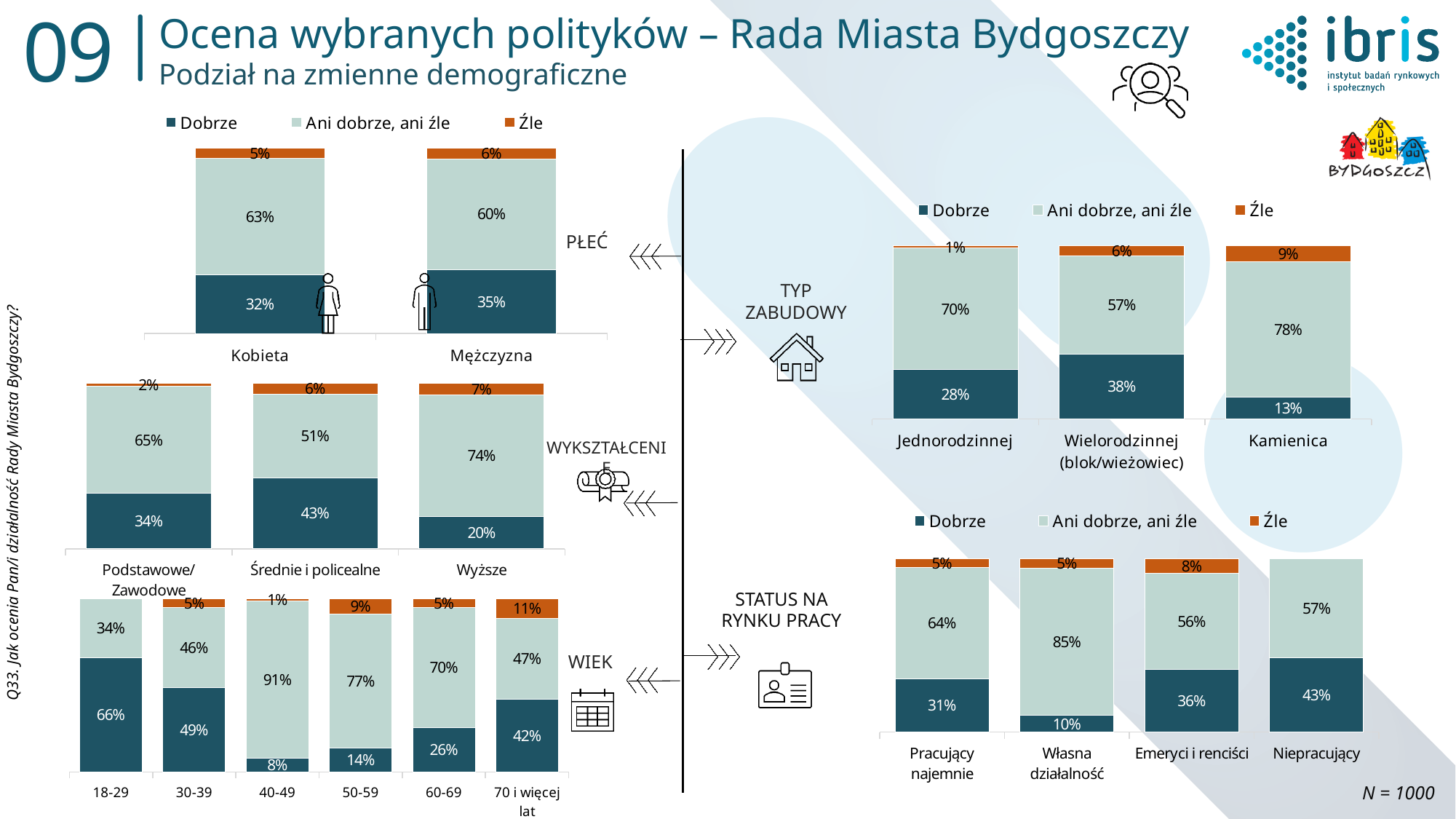
In the PŁEĆ chart, what percentage of women (Kobieta) rated the council 'Dobrze'? 32% In the WIEK chart, what is the difference between the 'Dobrze' values for 18-29 and 30-39? 17% In the STATUS NA RYNKU PRACY chart, how many series does the legend list? 3 In the WYKSZTAŁCENIE chart, what is the 'Ani dobrze, ani źle' value for Wyższe? 74% In the WIEK chart, which age group has the highest 'Dobrze' share? 18-29 In the STATUS NA RYNKU PRACY chart, what is the 'Dobrze' value for Własna działalność? 10% In the WIEK chart, what is the 'Ani dobrze, ani źle' value for the 40-49 group? 91% In the WIEK chart, how many age groups are shown? 6 In the WYKSZTAŁCENIE chart, which education group has the highest 'Dobrze' share? Średnie i policealne In the TYP ZABUDOWY chart, which building type has the lowest 'Dobrze' share? Kamienica In the PŁEĆ chart, what is the 'Ani dobrze, ani źle' value for Mężczyzna? 60% In the TYP ZABUDOWY chart, what is the 'Źle' value for Wielorodzinnej (blok/wieżowiec)? 6%